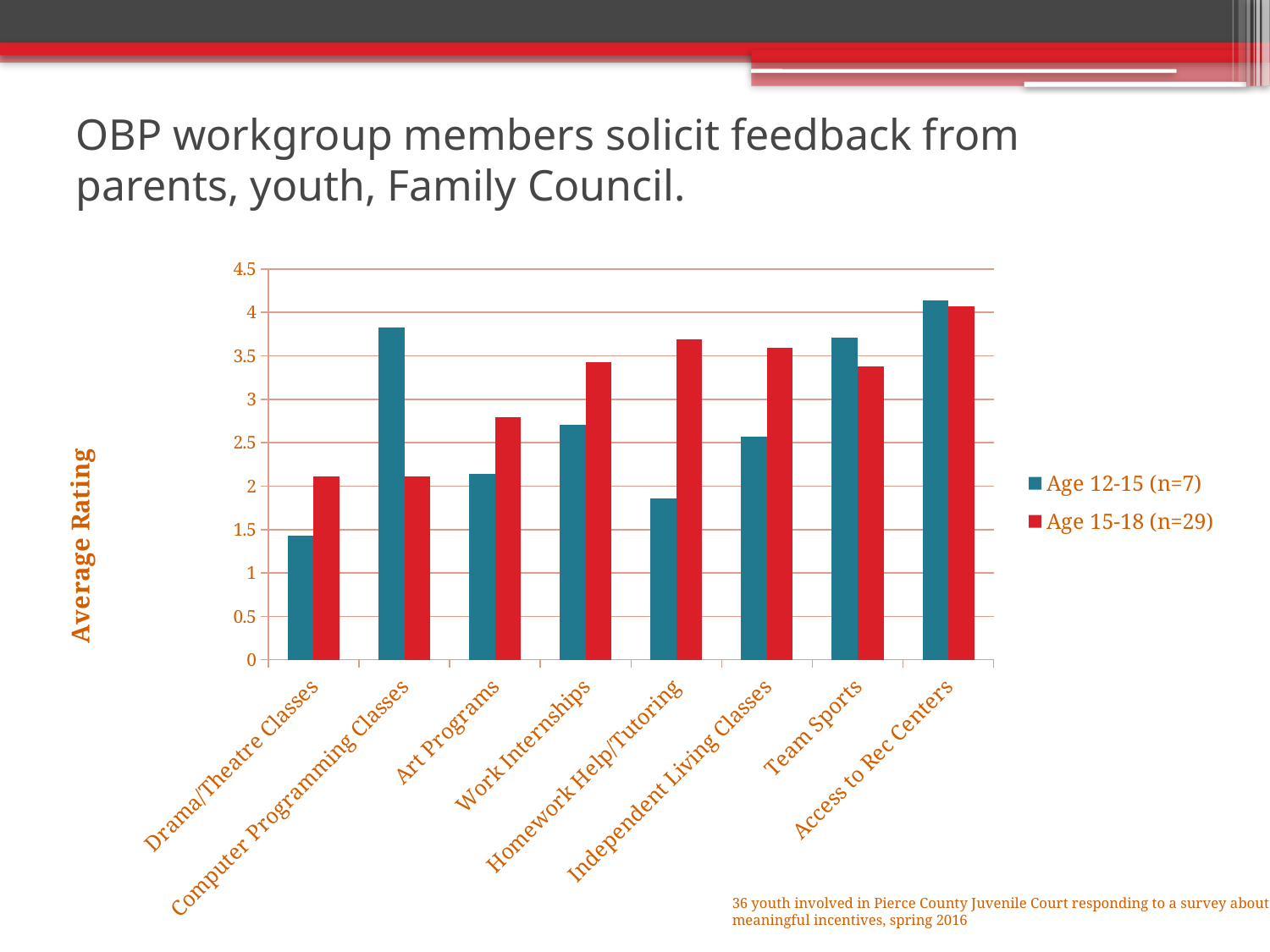
What kind of chart is shown on the slide? bar chart Which category has the lowest value for Age 12-15 (n=7)? Drama/Theatre Classes How many series does the legend list? 2 Which category has the highest value for Age 12-15 (n=7)? Access to Rec Centers What is the title of the vertical axis? Average Rating Which category has the highest value for Age 15-18 (n=29)? Access to Rec Centers Is the value for Art Programs for Age 15-18 (n=29) greater or less than 3? less How many categories are shown on the x axis? 8 Is the value for Computer Programming Classes for Age 12-15 (n=7) greater or less than 3.5? greater For Computer Programming Classes, which series has the larger value, Age 12-15 (n=7) or Age 15-18 (n=29)? Age 12-15 (n=7) For Homework Help/Tutoring, which series has the larger value, Age 12-15 (n=7) or Age 15-18 (n=29)? Age 15-18 (n=29) Is the value for Homework Help/Tutoring for Age 12-15 (n=7) greater or less than 2? less